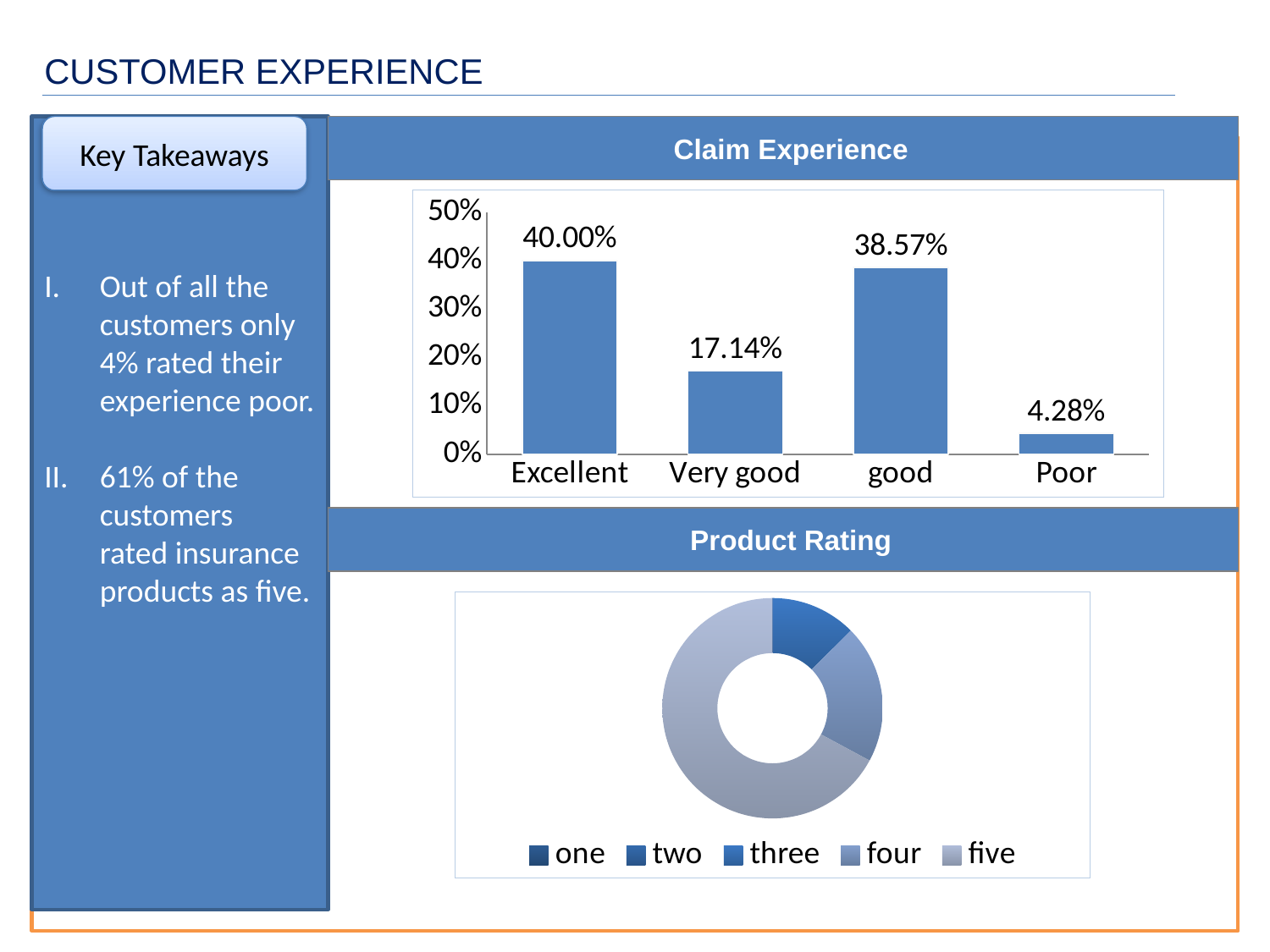
In the Claim Experience chart, what is the difference between the good and Very good values? 21.43% In the Claim Experience chart, which category has the lowest value? Poor What kind of chart is the Claim Experience chart? bar chart In the Claim Experience chart, which is larger, the value for Very good or the value for good? good How many categories are shown on the x axis of the Claim Experience chart? 4 How many entries does the legend of the Product Rating chart list? 5 In the Claim Experience chart, what is the value for Poor? 4.28% In the Claim Experience chart, what is the difference between the Excellent and Poor values? 35.72% In the Claim Experience chart, what percentage of customers rated their claim experience Excellent? 40.00% In the Claim Experience chart, which category has the highest value? Excellent In the Claim Experience chart, is the value for Very good greater or less than 20%? less In the Claim Experience chart, what is the value for Very good? 17.14%